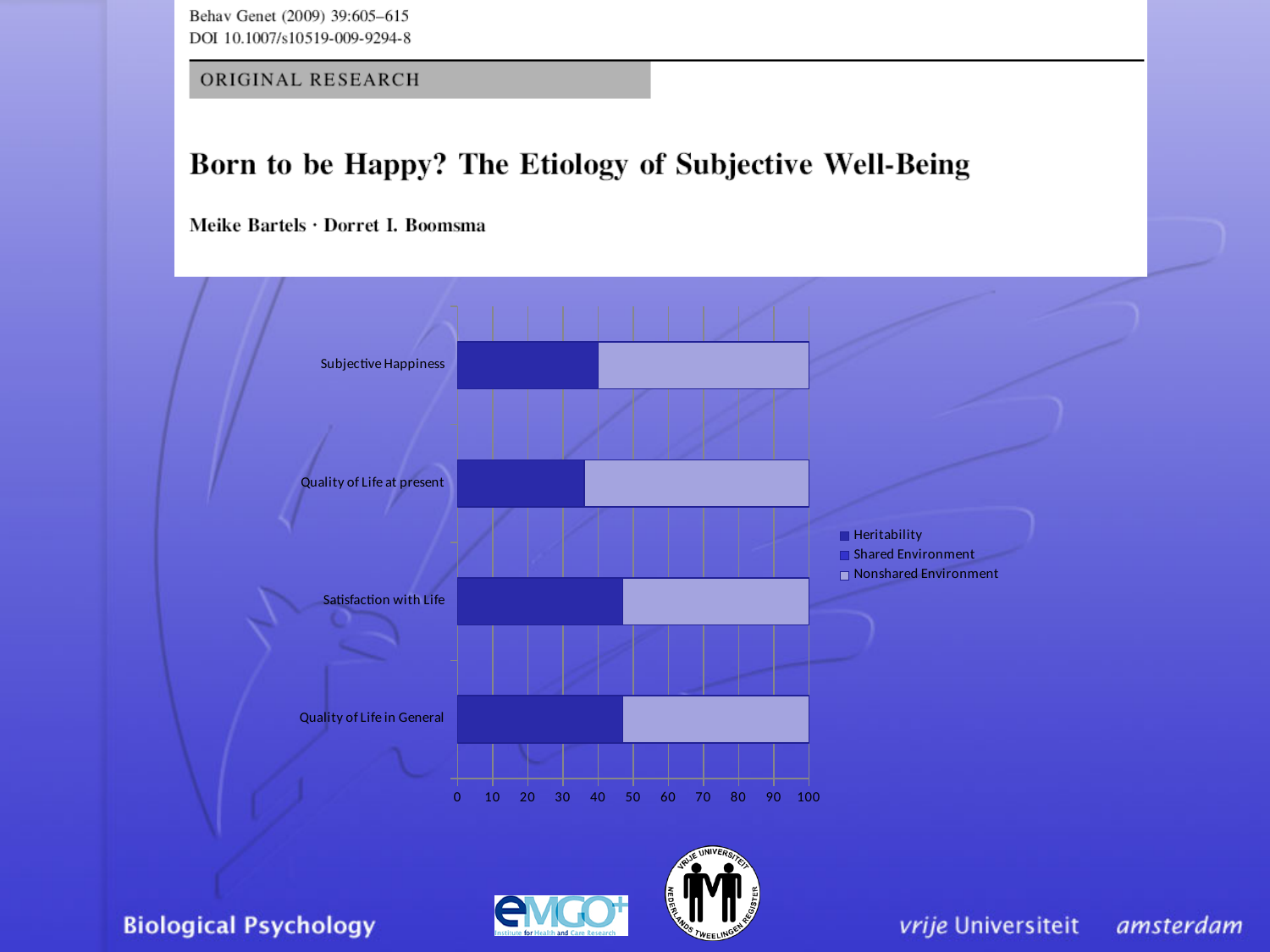
What kind of chart is shown on the slide? bar chart Is the Heritability value for Quality of Life at present greater or less than 40? less Is the Heritability value for Quality of Life in General greater or less than 40? greater Which has the larger Heritability value, Satisfaction with Life or Subjective Happiness? Satisfaction with Life How many categories are plotted on the chart? 4 What is the highest value shown on the chart's horizontal axis? 100 How many series does the chart's legend list? 3 Is the Heritability value for Satisfaction with Life greater or less than 40? greater Which series are listed in the chart's legend? Heritability, Shared Environment, Nonshared Environment Which category has the lowest Heritability value? Quality of Life at present Which has the larger Heritability value, Quality of Life in General or Quality of Life at present? Quality of Life in General